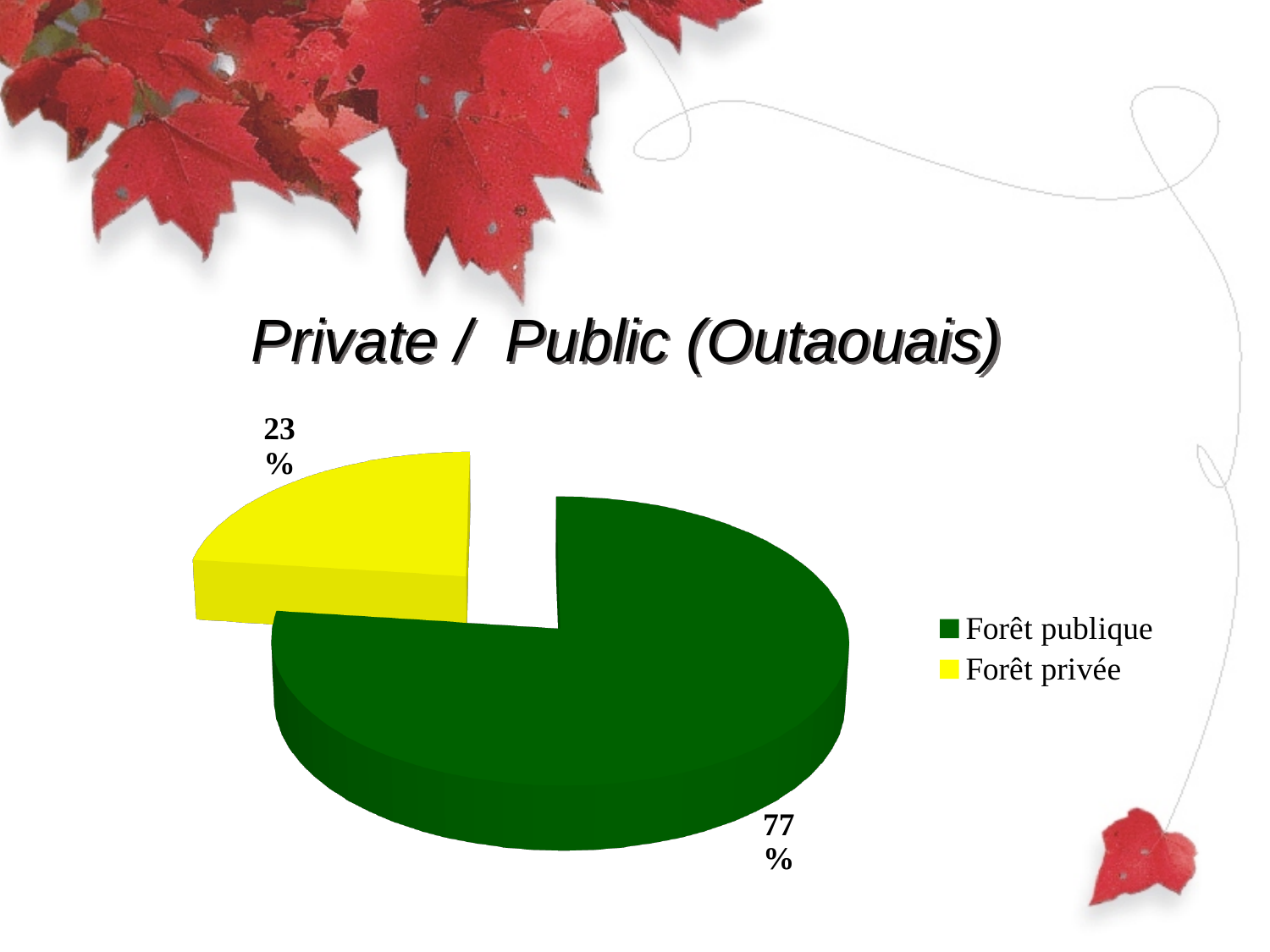
What kind of chart is shown on the slide? pie chart What share of the pie does Forêt publique represent? 77% What is the difference in percentage points between Forêt publique and Forêt privée? 54 What colour is the Forêt privée slice? yellow What is the total of the two slice percentages shown? 100% What is the title of the slide containing the pie chart? Private / Public (Outaouais) What share of the pie does Forêt privée represent? 23% How many slices does the pie chart have? 2 How many entries does the legend list? 2 Which category has the smallest slice of the pie? Forêt privée Which is larger, the share for Forêt publique or the share for Forêt privée? Forêt publique Which category has the largest slice of the pie? Forêt publique